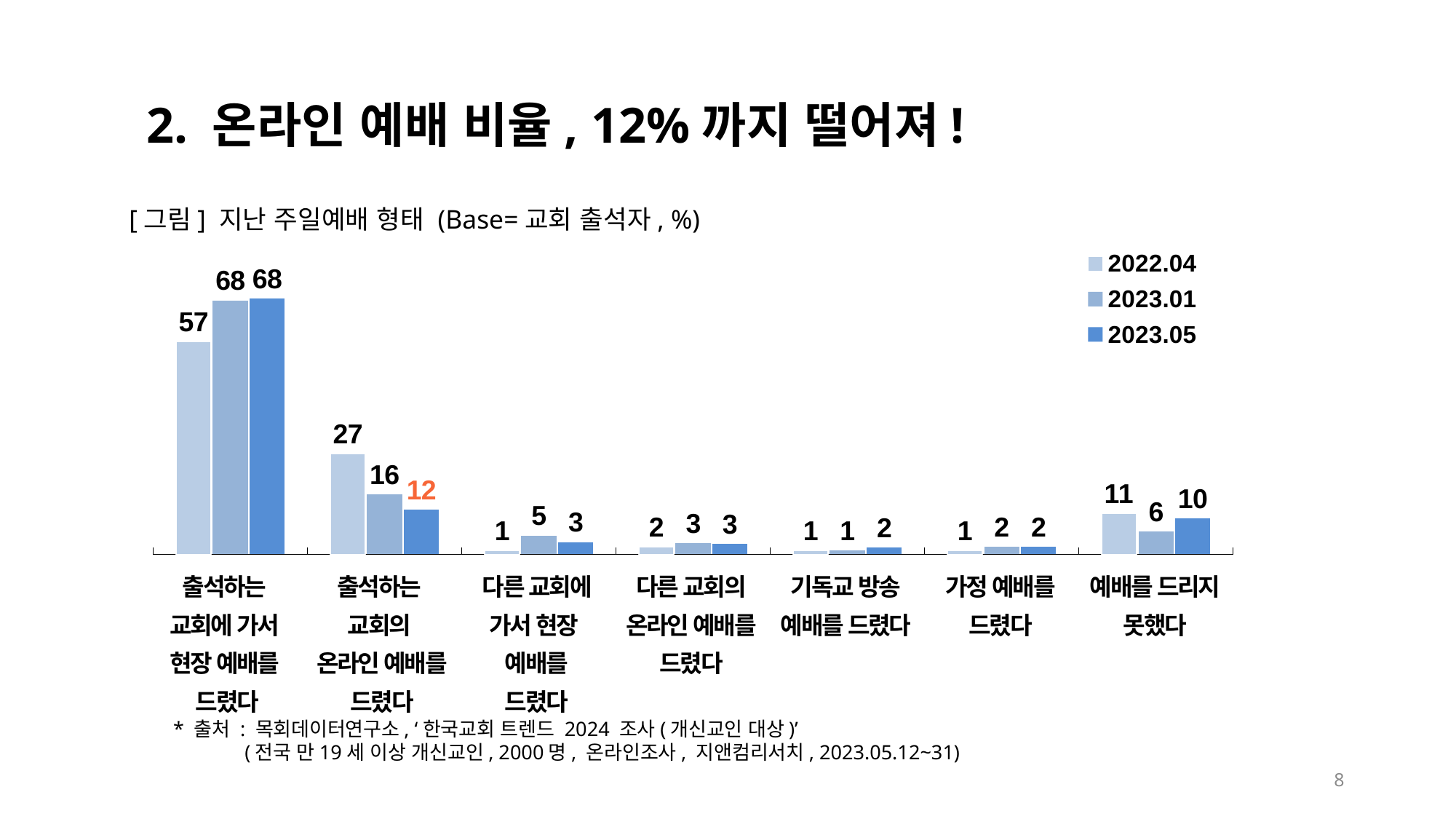
Which legend entry is shown with the darkest blue colour? 2023.05 What type of chart is shown on the slide? bar chart What is the value for 2023.01 in the category '다른 교회에 가서 현장 예배를 드렸다'? 5 What is the value for 2022.04 in the category '출석하는 교회에 가서 현장 예배를 드렸다'? 57 What is the value for 2023.05 in the category '출석하는 교회의 온라인 예배를 드렸다'? 12 What is the difference between the 2022.04 and 2023.05 values for '출석하는 교회의 온라인 예배를 드렸다'? 15 Do the values for '출석하는 교회의 온라인 예배를 드렸다' rise or fall from 2022.04 to 2023.05? fall How many series does the legend list? 3 Which category has the highest value for 2023.05? 출석하는 교회에 가서 현장 예배를 드렸다 What is the value for 2023.01 in the category '예배를 드리지 못했다'? 6 How many categories are shown on the x axis? 7 Which is larger for '예배를 드리지 못했다': the 2022.04 value or the 2023.05 value? 2022.04